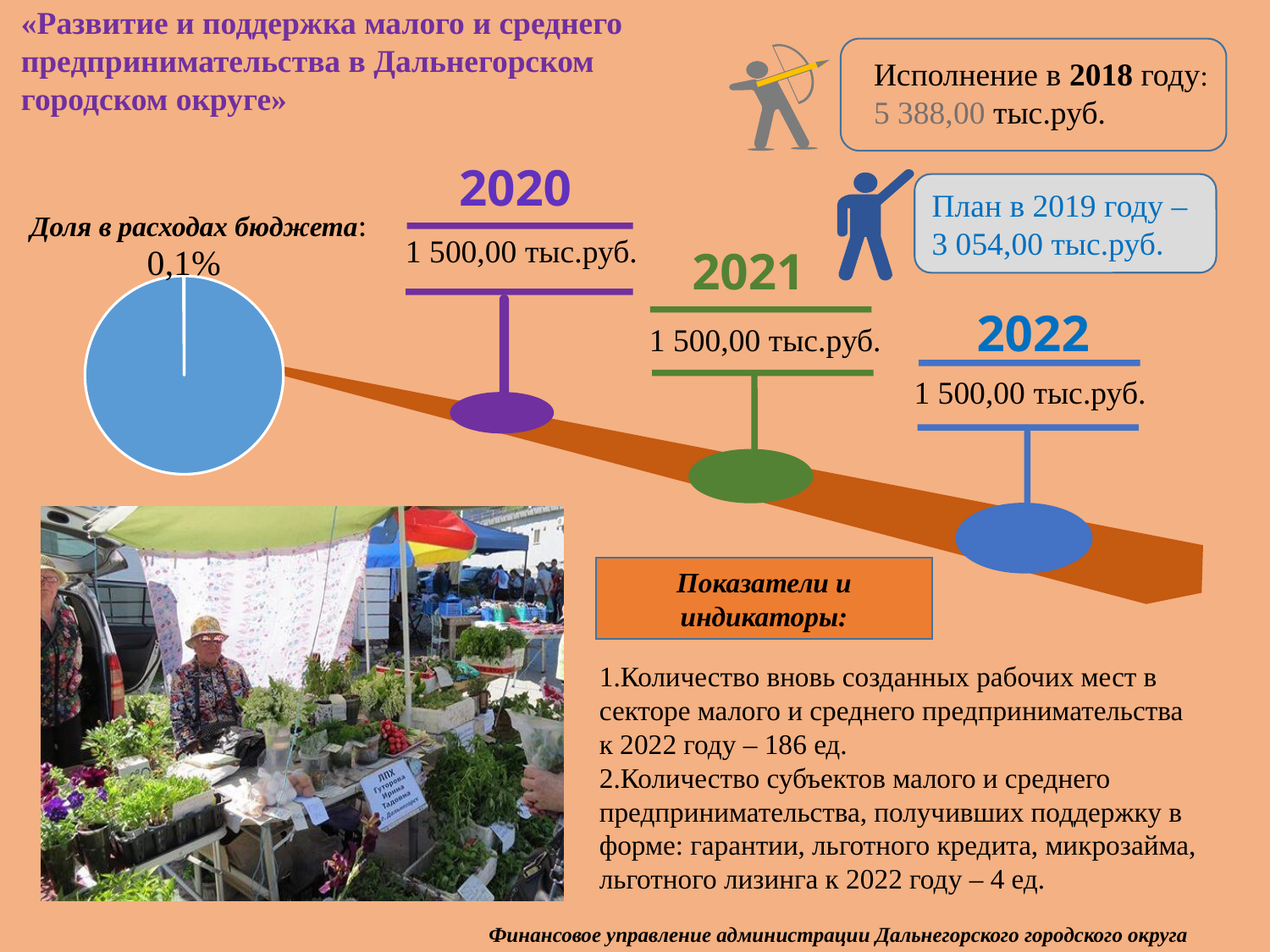
What kind of chart is shown under the heading «Доля в расходах бюджета»? pie chart On the timeline chart, do the amounts rise, fall or stay the same from 2020 to 2022? stay the same What colour is the large slice of the pie chart «Доля в расходах бюджета»? blue On the timeline chart, what is the difference between the amounts for 2022 and 2020? 0,00 тыс.руб. How many years are marked on the timeline chart? 3 On the timeline chart, what amount is shown for 2020? 1 500,00 тыс.руб. What value is printed as the data label on the pie chart «Доля в расходах бюджета»? 0,1% What is the title of the pie chart on the left of the slide? Доля в расходах бюджета On the timeline chart, what amount is shown for 2022? 1 500,00 тыс.руб. On the timeline chart, what amount is shown for 2021? 1 500,00 тыс.руб.